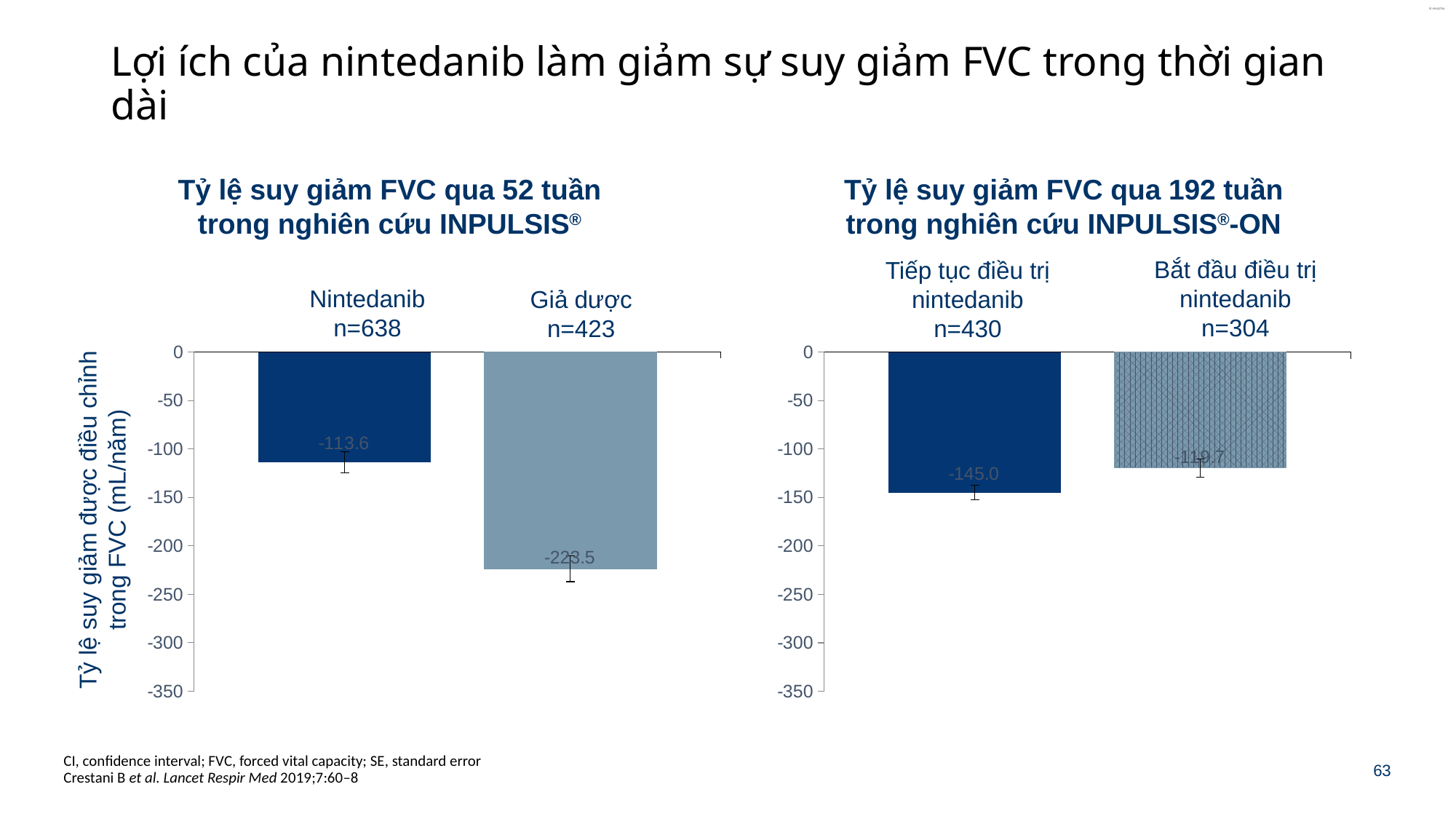
In the right chart (192 tuần, INPULSIS-ON), what is the difference between the two bar values? 25.3 In the right chart (192 tuần, INPULSIS-ON), which group has the more negative value? Tiếp tục điều trị nintedanib In the left chart (52 tuần, INPULSIS), what is the sample size (n) for the Nintedanib group? n=638 In the left chart (52 tuần, INPULSIS), which group has the larger decline in FVC (the more negative value)? Giả dược What is the y-axis label shared by the charts? Tỷ lệ suy giảm được điều chỉnh trong FVC (mL/năm) In the right chart (192 tuần, INPULSIS-ON), what is the value for Tiếp tục điều trị nintedanib? -145.0 In the left chart (52 tuần, INPULSIS), what is the value for Nintedanib? -113.6 In the right chart (192 tuần, INPULSIS-ON), what is the value for Bắt đầu điều trị nintedanib? -119.7 What type of chart is used on the right (192 tuần, INPULSIS-ON)? Bar chart How many bars are shown in the left chart (52 tuần, INPULSIS)? 2 In the left chart (52 tuần, INPULSIS), what is the difference between the Giả dược and Nintedanib values? 109.9 In the left chart (52 tuần, INPULSIS), what is the value for Giả dược? -223.5